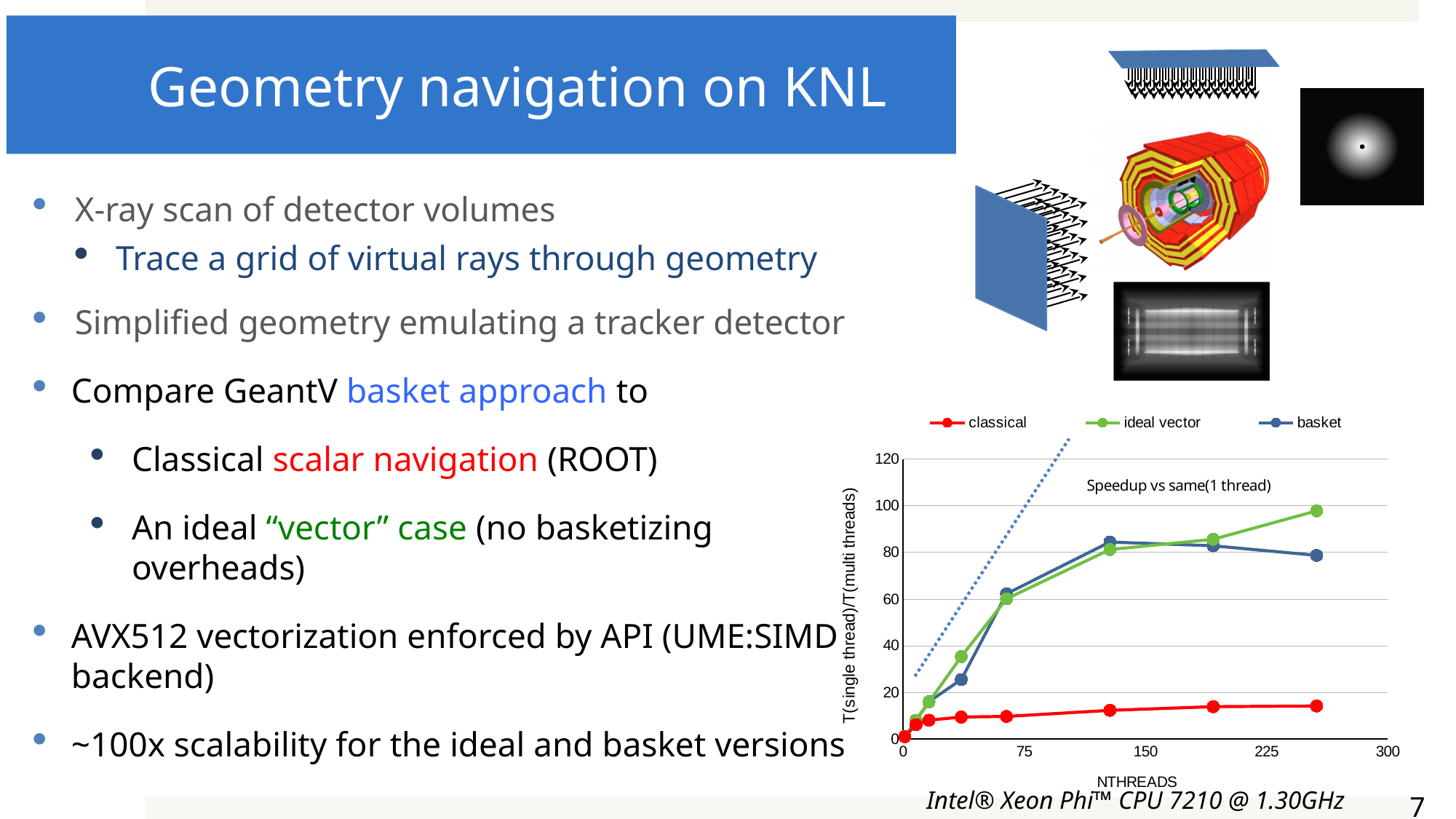
At the rightmost data point, is the value for ideal vector or basket larger? ideal vector What are the three series named in the chart legend? classical, ideal vector, basket How many series does the chart legend list? 3 Which series has the highest value at the right end of the chart (around 256 threads)? ideal vector Does the ideal vector series rise or fall as the number of threads increases? rise Is the value for ideal vector at the rightmost data point greater or less than 80? greater What is the label of the chart's x axis? NTHREADS Is the value for basket at about 32 threads greater or less than 40? less At the rightmost data point, is the value for basket or classical larger? basket Which series has the lowest values across the whole chart? classical Is the value for classical at the rightmost data point greater or less than 20? less What kind of chart is shown on the slide? line chart